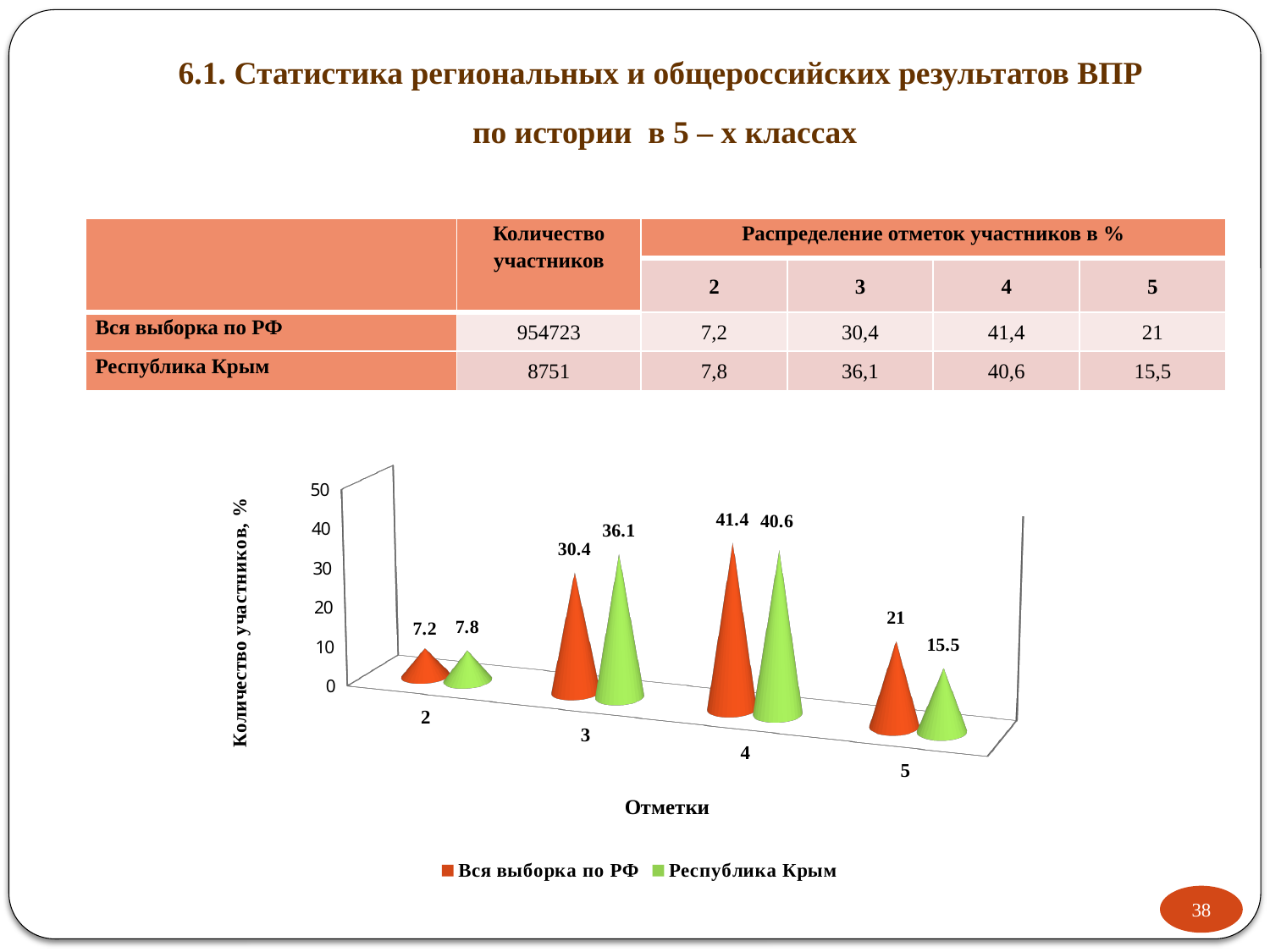
How many marks (categories) are shown on the x axis? 4 Is the value for Вся выборка по РФ at mark 4 greater or less than 40? greater What is the value for Республика Крым at mark 3? 36.1 What kind of chart is shown on the slide? bar chart What is the value for Вся выборка по РФ at mark 2? 7.2 What is the label of the x axis of the chart? Отметки Which mark has the highest value for Республика Крым? 4 Which mark has the lowest value for Вся выборка по РФ? 2 How many series does the legend list? 2 What is the value for Вся выборка по РФ at mark 5? 21 What is the difference between Вся выборка по РФ and Республика Крым at mark 5? 5.5 At mark 3, which series has the larger value: Вся выборка по РФ or Республика Крым? Республика Крым